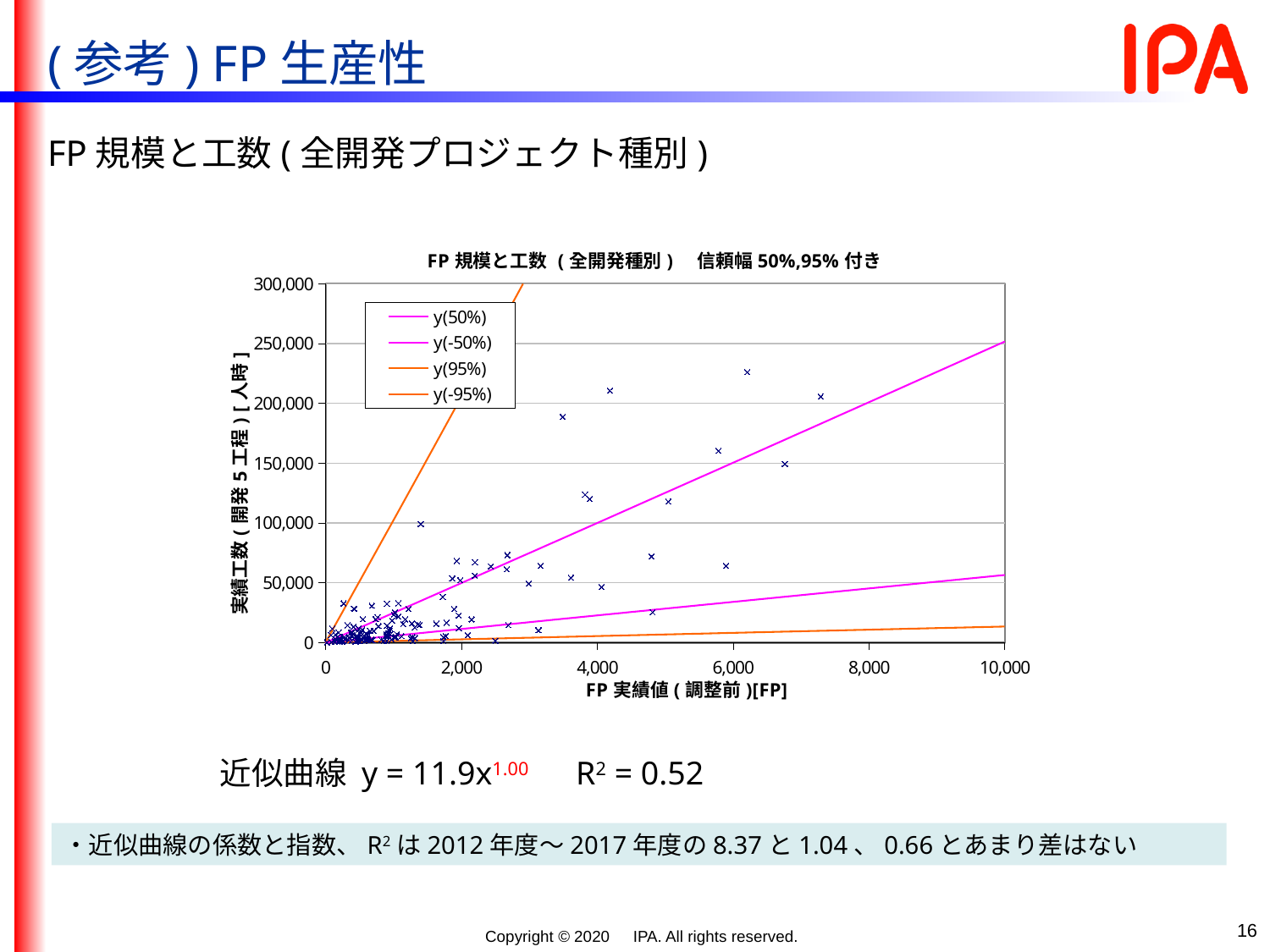
What kind of chart is shown on the slide? scatter chart What is the label of the x axis of the chart? FP実績値(調整前)[FP] At x = 10,000, is the value of the y(-95%) line greater or less than 50,000? less Is the highest plotted data point greater or less than 200,000 on the y axis? greater What is the highest tick value shown on the x axis of the chart? 10,000 At x = 10,000, is the value of the y(50%) line greater or less than 200,000? greater How many series does the chart legend list? 4 What is the highest tick value shown on the y axis of the chart? 300,000 Does the y(50%) line rise or fall as the x value increases? rise At x = 10,000, which line is higher, y(50%) or y(-50%)? y(50%) What is the title of the chart? FP規模と工数（全開発種別） 信頼幅50%,95%付き